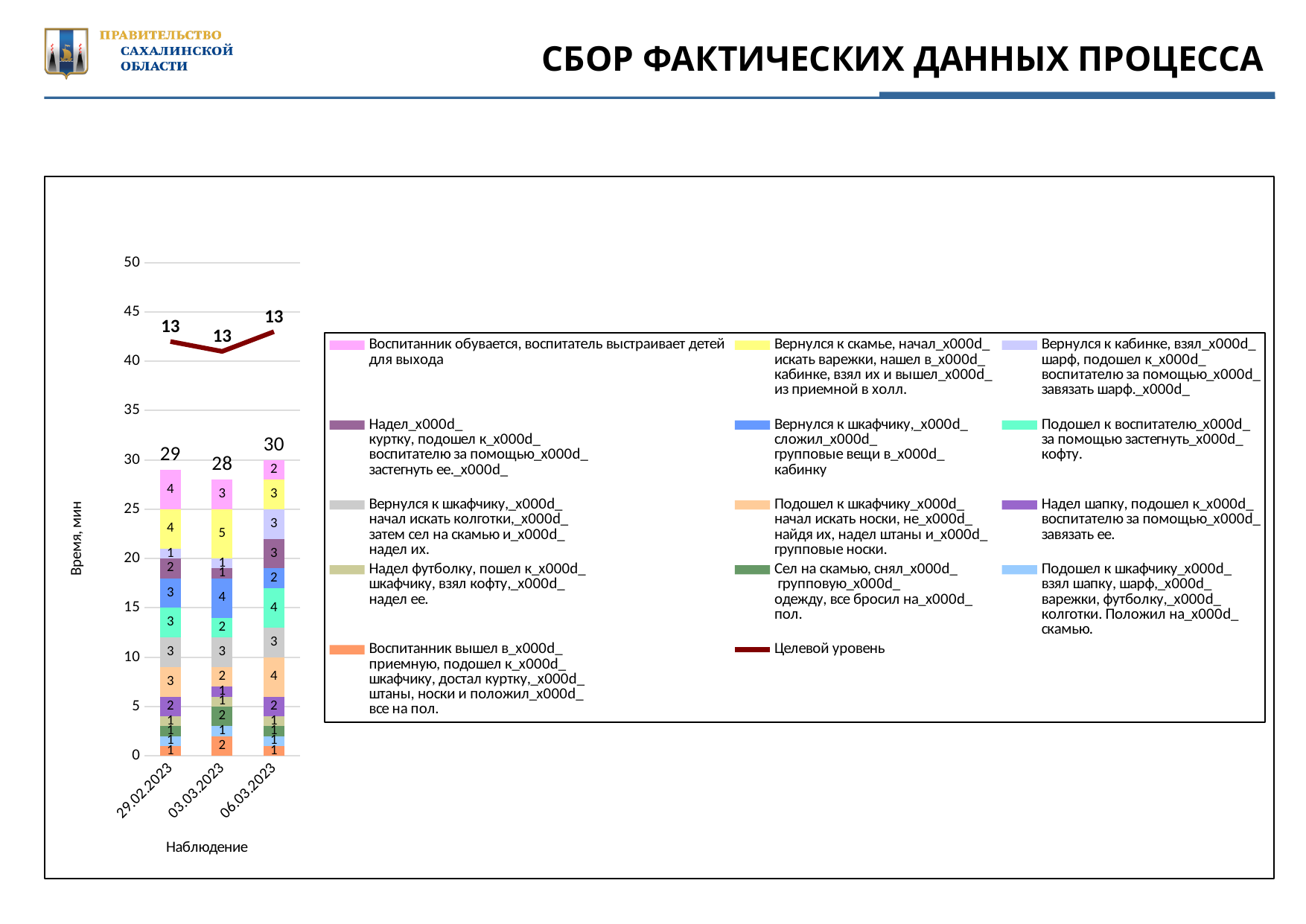
Which observation date has the lowest total bar value? 03.03.2023 What is the total height of the stacked bar for 29.02.2023? 29 What is the value of the 'Целевой уровень' line for 03.03.2023? 13 What is the value of the pink segment ('Воспитанник обувается, воспитатель выстраивает детей для выхода') in the bar for 29.02.2023? 4 Which observation date has the highest total bar value? 06.03.2023 How many observation dates are shown on the x axis? 3 What is the title of the y axis? Время, мин What is the difference between the total bar values for 06.03.2023 and 03.03.2023? 2 What is the value of the yellow segment ('Вернулся к скамье, начал искать варежки...') in the bar for 03.03.2023? 5 Is the total bar value for 29.02.2023 larger or smaller than the total for 03.03.2023? larger How many entries does the legend list? 14 What is the total height of the stacked bar for 06.03.2023? 30